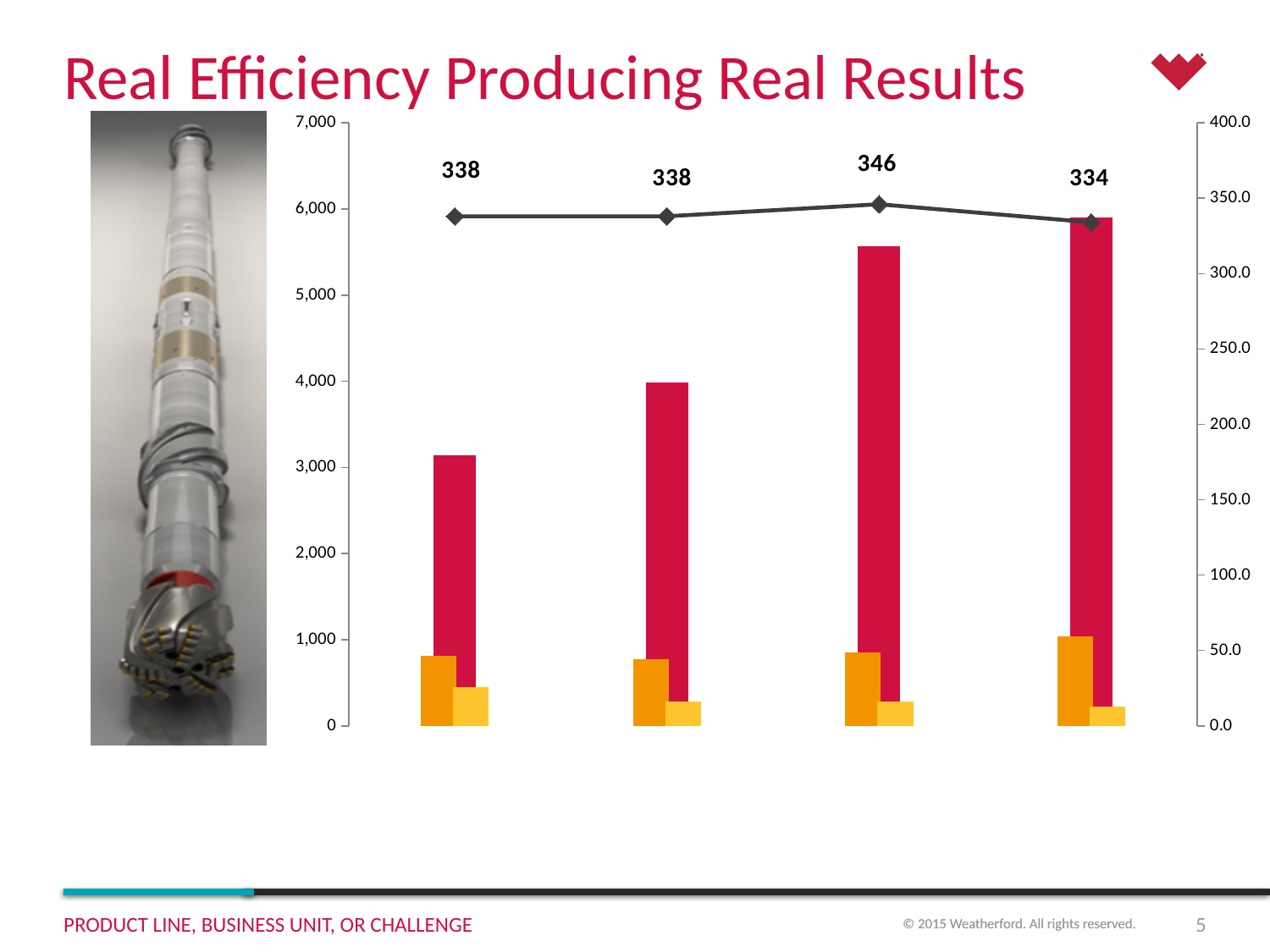
Is the red bar in the third group greater or less than 5,000 on the left axis? greater Which group has the tallest red bar? the fourth group What is the data label on the third point of the line series? 346 What is the data label on the first point of the line series? 338 How many groups of bars are plotted on the chart? 4 What is the difference between the highest and lowest labelled values on the line series? 12 Which point of the line series has the lowest labelled value? the fourth point (334) Which point of the line series has the highest labelled value? the third point (346) Is the yellow bar in the first group greater or less than 1,000 on the left axis? less What is the highest tick value shown on the right-hand axis? 400.0 What kind of chart is shown on the slide? bar and line chart Do the red bars rise or fall from left to right across the chart? rise